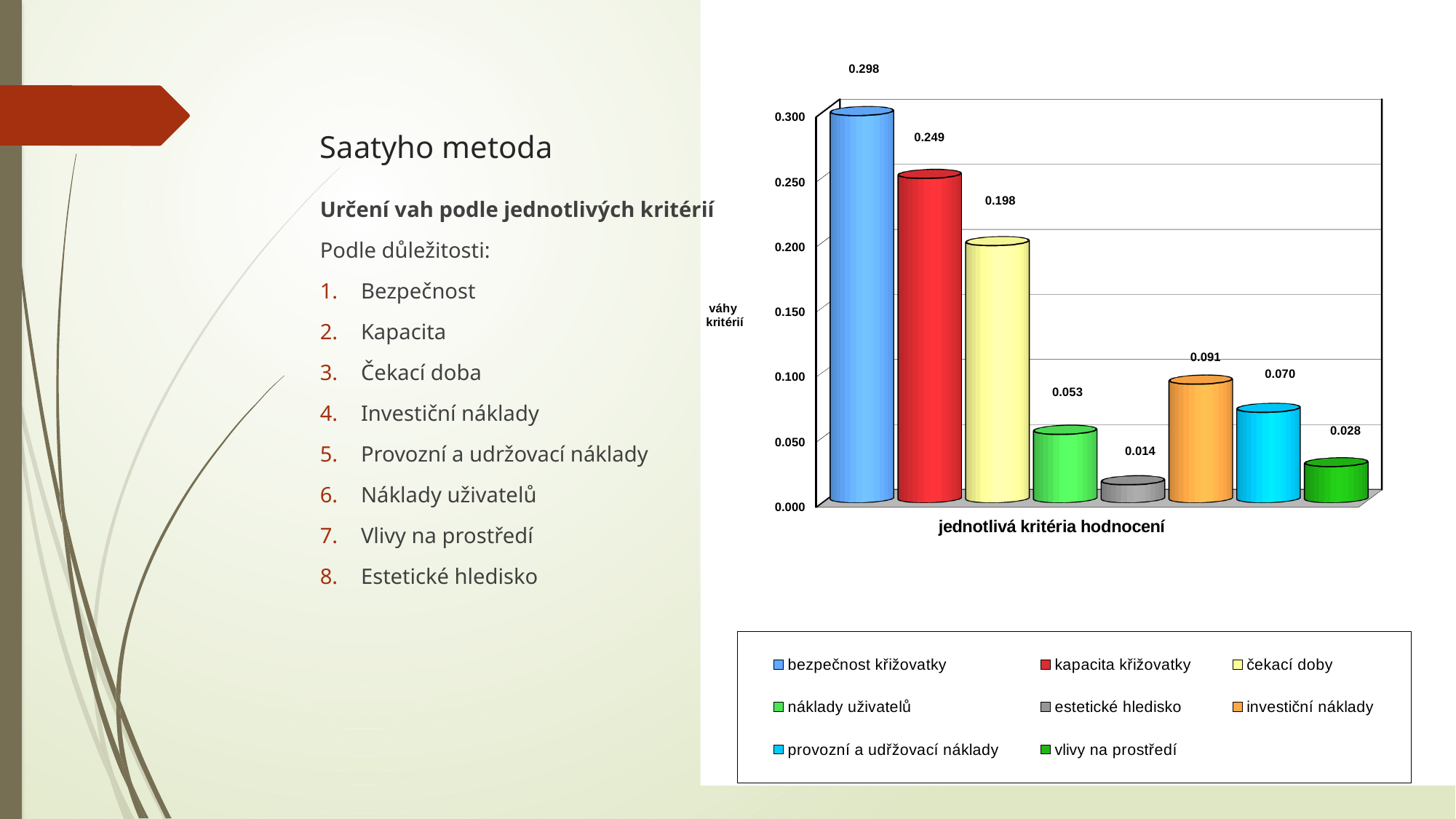
How many bars are plotted in the chart? 8 What is the value for estetické hledisko? 0.014 What is the difference between the values for bezpečnost křižovatky and kapacita křižovatky? 0.049 Which is larger, the value for náklady uživatelů or the value for vlivy na prostředí? náklady uživatelů What is the value for provozní a udržovací náklady? 0.070 Is the value for čekací doby greater or less than 0.150? greater How many entries does the legend list? 8 What is the value for investiční náklady? 0.091 What kind of chart is shown on the slide? bar chart What is the value for bezpečnost křižovatky? 0.298 Which criterion has the highest weight? bezpečnost křižovatky Which criterion has the lowest weight? estetické hledisko